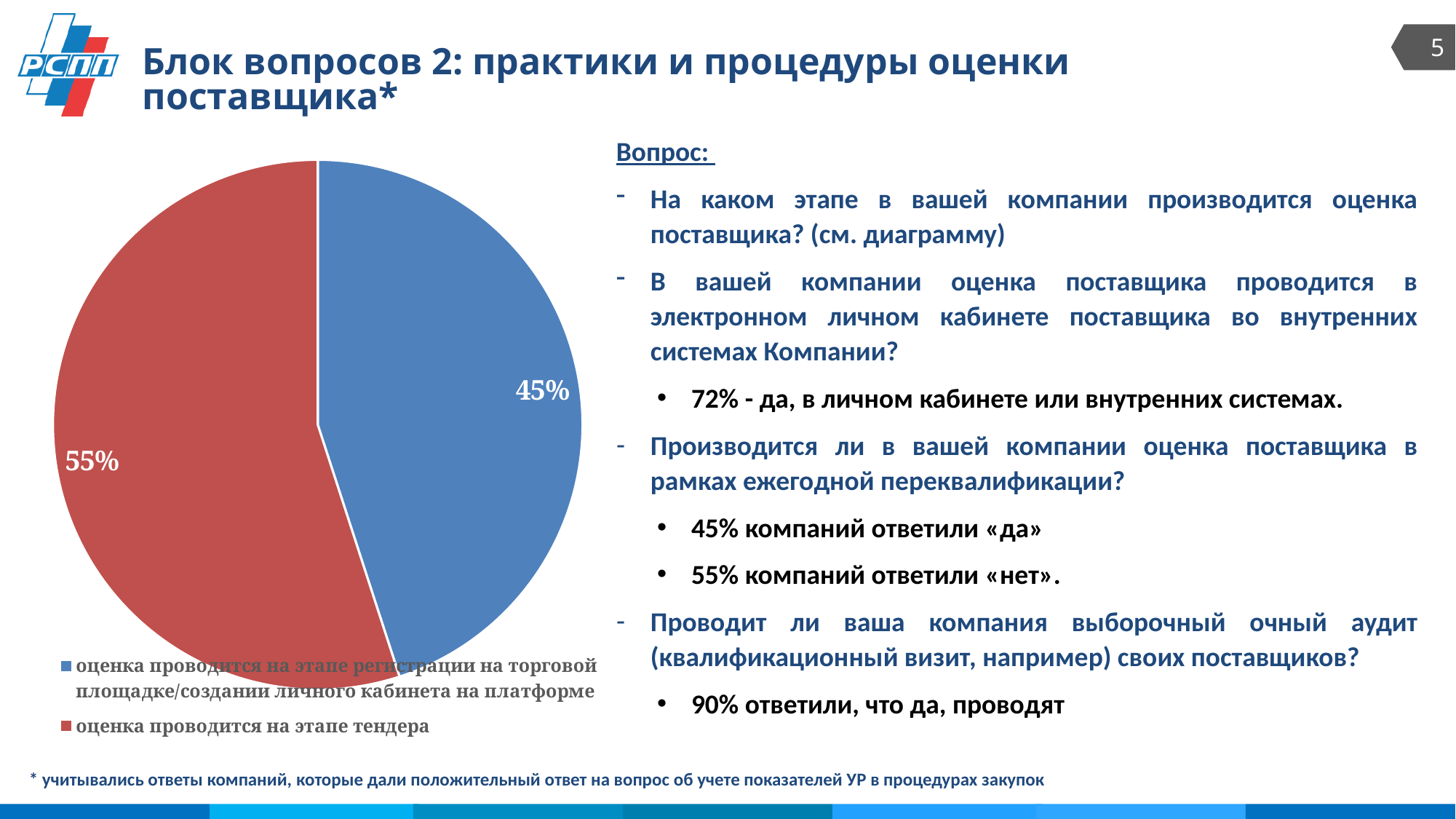
How many slices does the pie chart have? 2 What colour is the slice for "оценка проводится на этапе регистрации на торговой площадке/создании личного кабинета на платформе"? blue What is the total of the two slice percentages shown on the pie chart? 100% What is the difference in percentage points between the slice for "оценка проводится на этапе тендера" and the slice for "оценка проводится на этапе регистрации на торговой площадке/создании личного кабинета на платформе"? 10 percentage points What share of the pie does the slice "оценка проводится на этапе тендера" have? 55% Which is larger: the slice for "оценка проводится на этапе тендера" or the slice for "оценка проводится на этапе регистрации на торговой площадке/создании личного кабинета на платформе"? оценка проводится на этапе тендера What colour is the slice for "оценка проводится на этапе тендера"? red Which category has the largest slice of the pie? оценка проводится на этапе тендера What kind of chart is shown on the slide? pie chart How many entries does the legend of the pie chart list? 2 What share of the pie does the slice "оценка проводится на этапе регистрации на торговой площадке/создании личного кабинета на платформе" have? 45% Which category has the smallest slice of the pie? оценка проводится на этапе регистрации на торговой площадке/создании личного кабинета на платформе